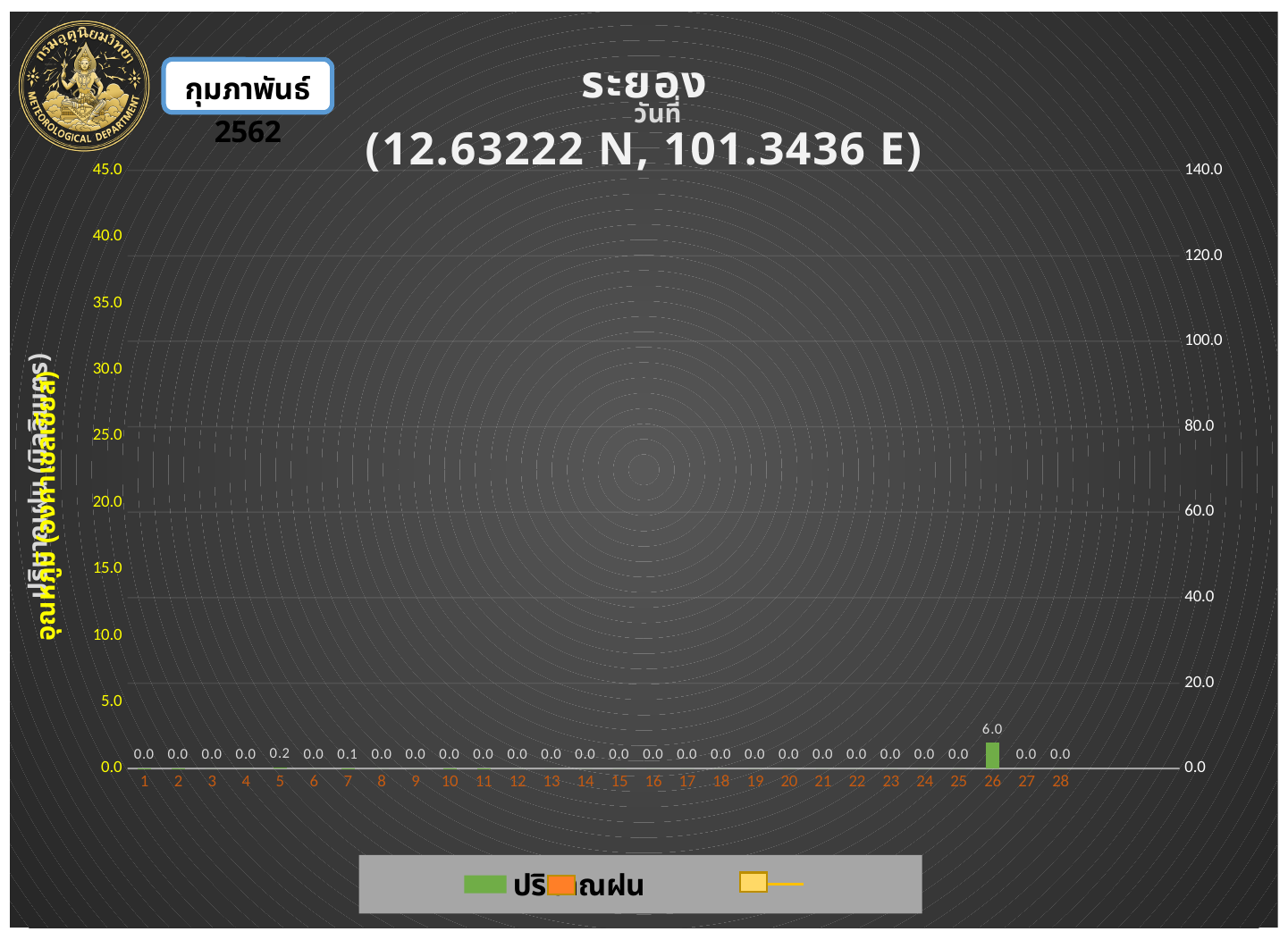
How many days are shown on the x axis? 28 What is the rainfall value shown for day 26? 6.0 What is the rainfall value shown for day 5? 0.2 What is the rainfall value shown for day 14? 0.0 What is the highest value shown on the left vertical axis? 45.0 What kind of chart is used to show the daily rainfall values? bar chart What is the difference between the rainfall values for day 26 and day 5? 5.8 Which is larger, the rainfall value for day 5 or for day 7? day 5 Which day has the highest rainfall value? 26 What is the highest value shown on the right vertical axis? 140.0 Is the rainfall value for day 26 greater or less than 10.0? less What is the rainfall value shown for day 7? 0.1